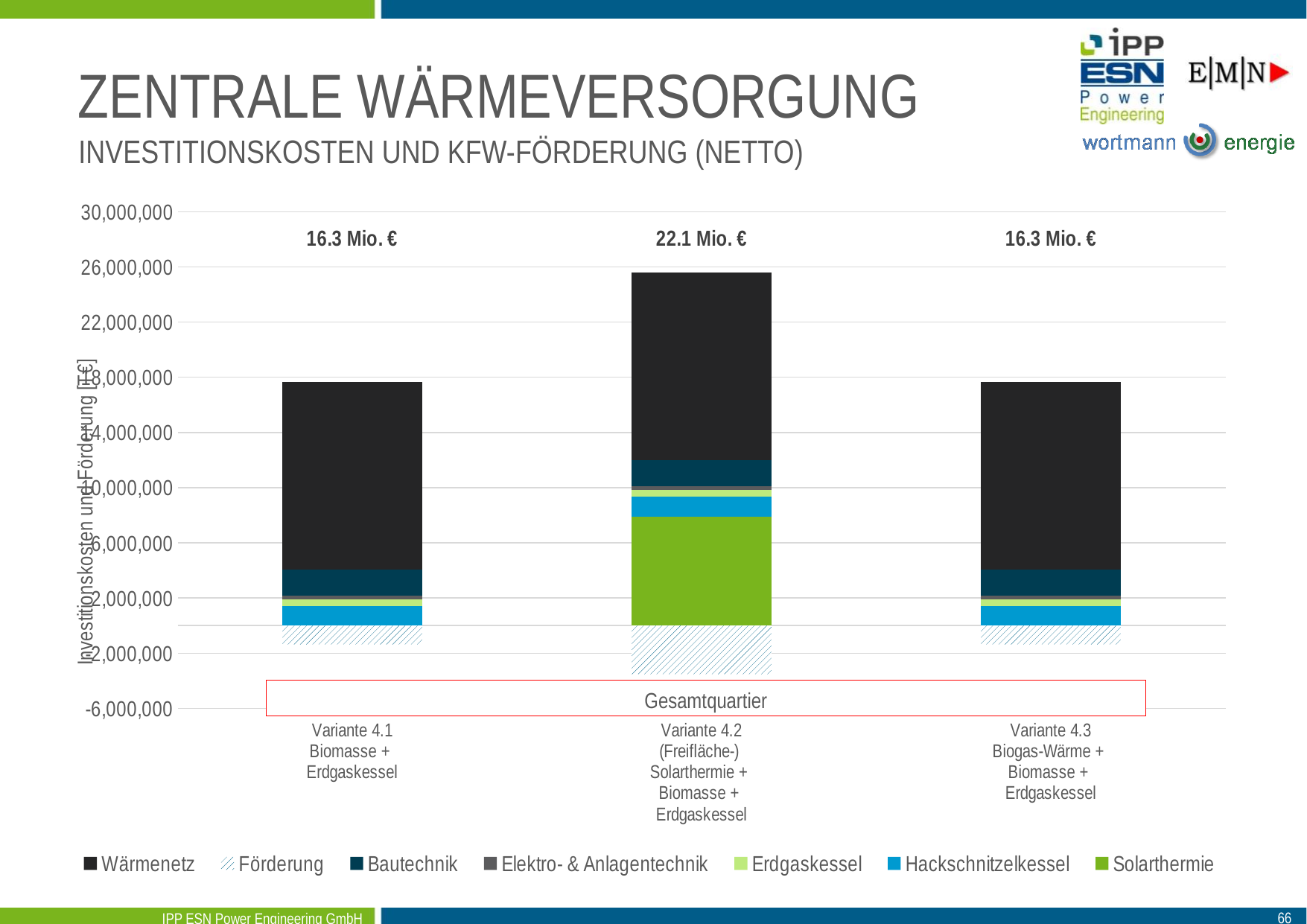
Is the top of the stacked bar for Variante 4.2 greater or less than 22,000,000? greater How many variants (categories) are shown on the x axis? 3 Which legend series is drawn with a hatched pattern? Förderung What total investment cost is labelled above the bar for Variante 4.3? 16.3 Mio. € What total investment cost is labelled above the bar for Variante 4.1? 16.3 Mio. € How many series does the legend list? 7 Which variant has the highest labelled total investment cost? Variante 4.2 What total investment cost is labelled above the bar for Variante 4.2? 22.1 Mio. € Which has the larger labelled total: Variante 4.2 or Variante 4.3? Variante 4.2 Is the top of the stacked bar for Variante 4.1 greater or less than 14,000,000? greater What kind of chart is shown on the slide? Stacked bar chart What is the difference between the labelled totals of Variante 4.2 and Variante 4.1? 5.8 Mio. €